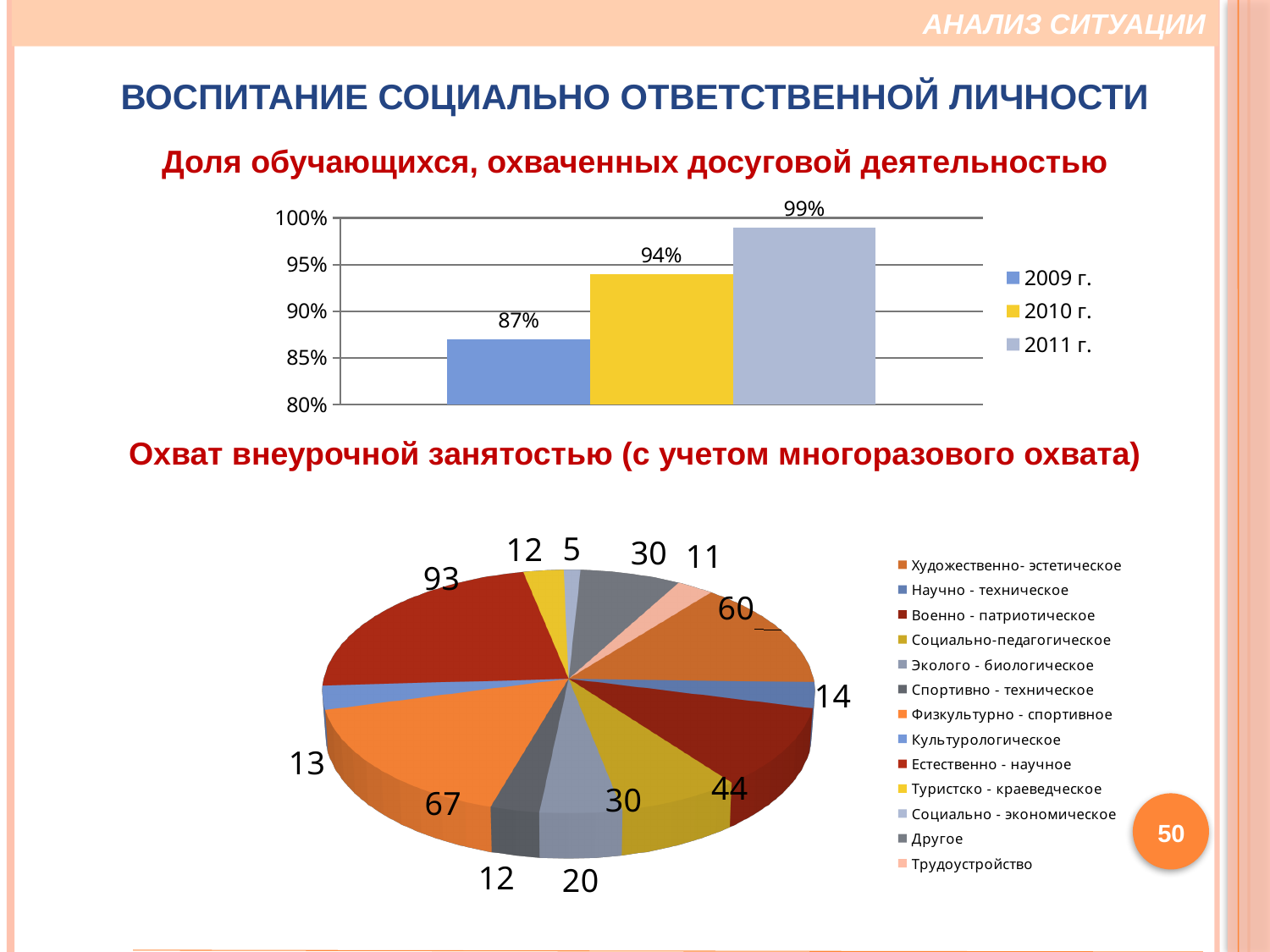
In the bar chart 'Доля обучающихся, охваченных досуговой деятельностью', which year has the highest value? 2011 г. In the pie chart 'Охват внеурочной занятостью (с учетом многоразового охвата)', what is the largest value shown on a slice? 93 In the bar chart 'Доля обучающихся, охваченных досуговой деятельностью', what is the value for 2010 г.? 94% What kind of chart is the upper chart 'Доля обучающихся, охваченных досуговой деятельностью'? bar chart What kind of chart is the lower chart 'Охват внеурочной занятостью (с учетом многоразового охвата)'? pie chart In the bar chart 'Доля обучающихся, охваченных досуговой деятельностью', which year has the lowest value? 2009 г. In the pie chart 'Охват внеурочной занятостью (с учетом многоразового охвата)', how many categories does the legend list? 13 In the bar chart 'Доля обучающихся, охваченных досуговой деятельностью', what is the value for 2011 г.? 99% In the bar chart 'Доля обучающихся, охваченных досуговой деятельностью', what is the value for 2009 г.? 87% In the bar chart 'Доля обучающихся, охваченных досуговой деятельностью', do the values rise or fall from 2009 to 2011? rise In the bar chart 'Доля обучающихся, охваченных досуговой деятельностью', what is the difference between the 2011 г. and 2009 г. values? 12% In the bar chart 'Доля обучающихся, охваченных досуговой деятельностью', how many entries does the legend list? 3